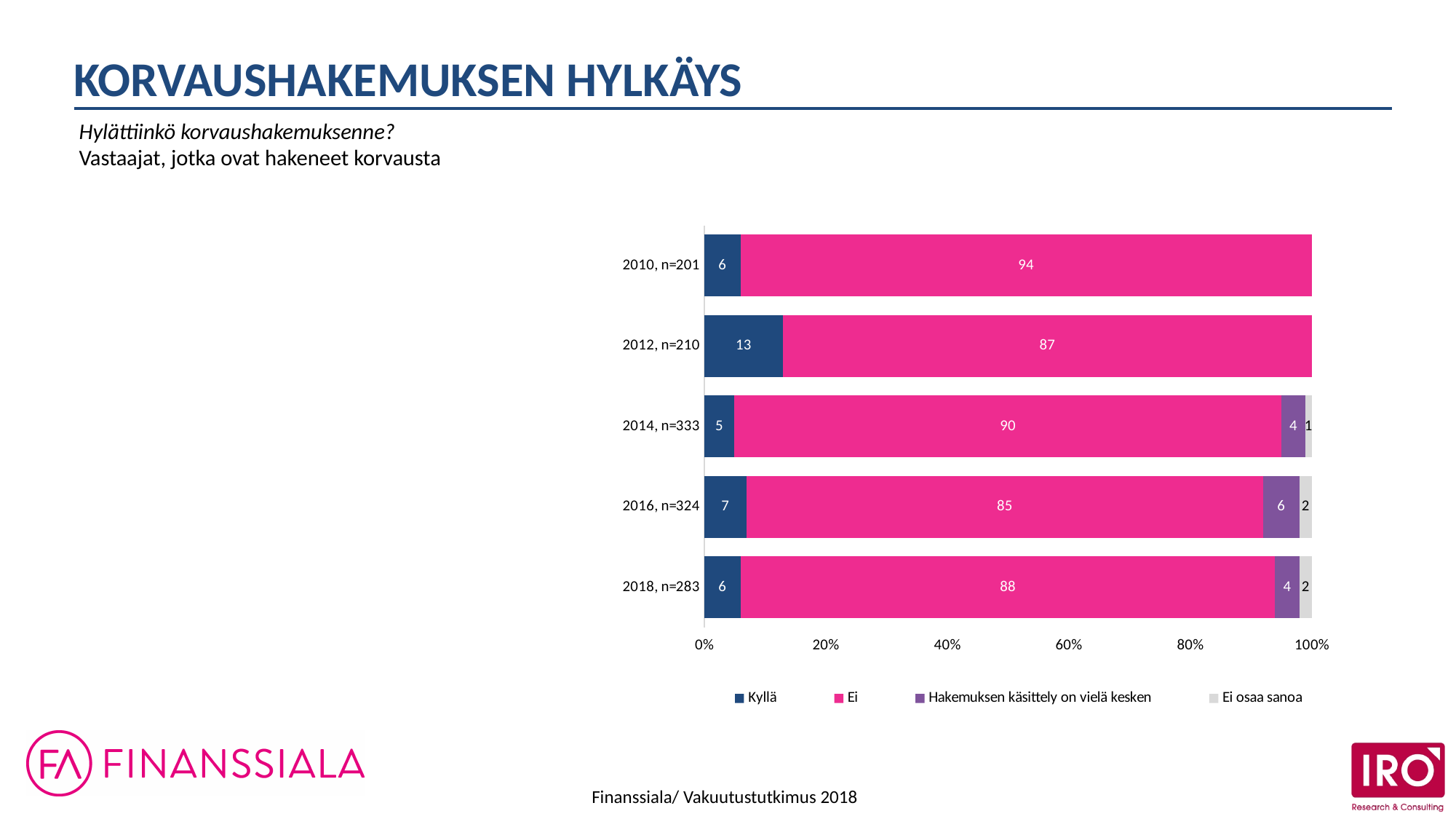
What is the value for "Hakemuksen käsittely on vielä kesken" in the 2016, n=324 bar? 6 How many year categories are shown on the chart? 5 What is the value for "Ei osaa sanoa" in the 2014, n=333 bar? 1 What kind of chart is shown on the slide? Stacked bar chart What is the difference between the "Ei" values for 2010, n=201 and 2012, n=210? 7 Which year has the highest value for "Kyllä"? 2012, n=210 Which legend entry is shown in pink? Ei What is the value for "Kyllä" in the 2012, n=210 bar? 13 How many series does the legend list? 4 What is the value for "Ei" in the 2018, n=283 bar? 88 Is the "Ei" value larger for 2014, n=333 or for 2018, n=283? 2014, n=333 Which year has the lowest value for "Ei"? 2016, n=324